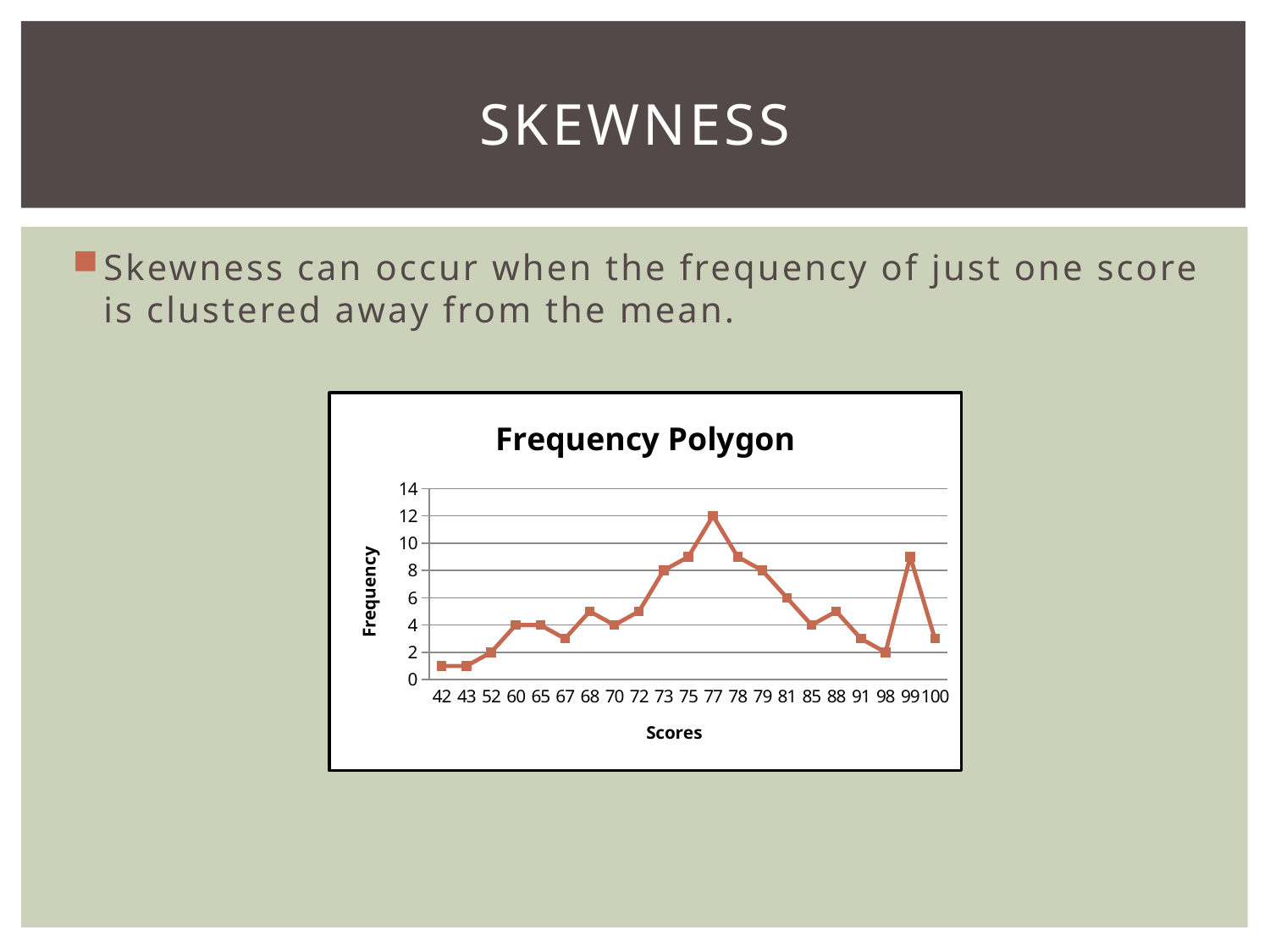
What is the difference between the frequency for score 77 and the frequency for score 79? 4 How many scores are plotted along the x axis of the chart? 21 Which has a higher frequency, score 77 or score 99? 77 What is the frequency for the score 79? 8 What is the frequency for the score 77? 12 What is the title of the chart? Frequency Polygon What is the frequency for the score 98? 2 What is the label of the vertical axis of the chart? Frequency Is the frequency for score 99 greater or less than 6? greater What is the frequency for the score 81? 6 What type of chart is shown on the slide? Line chart Which score has the highest frequency in the chart? 77